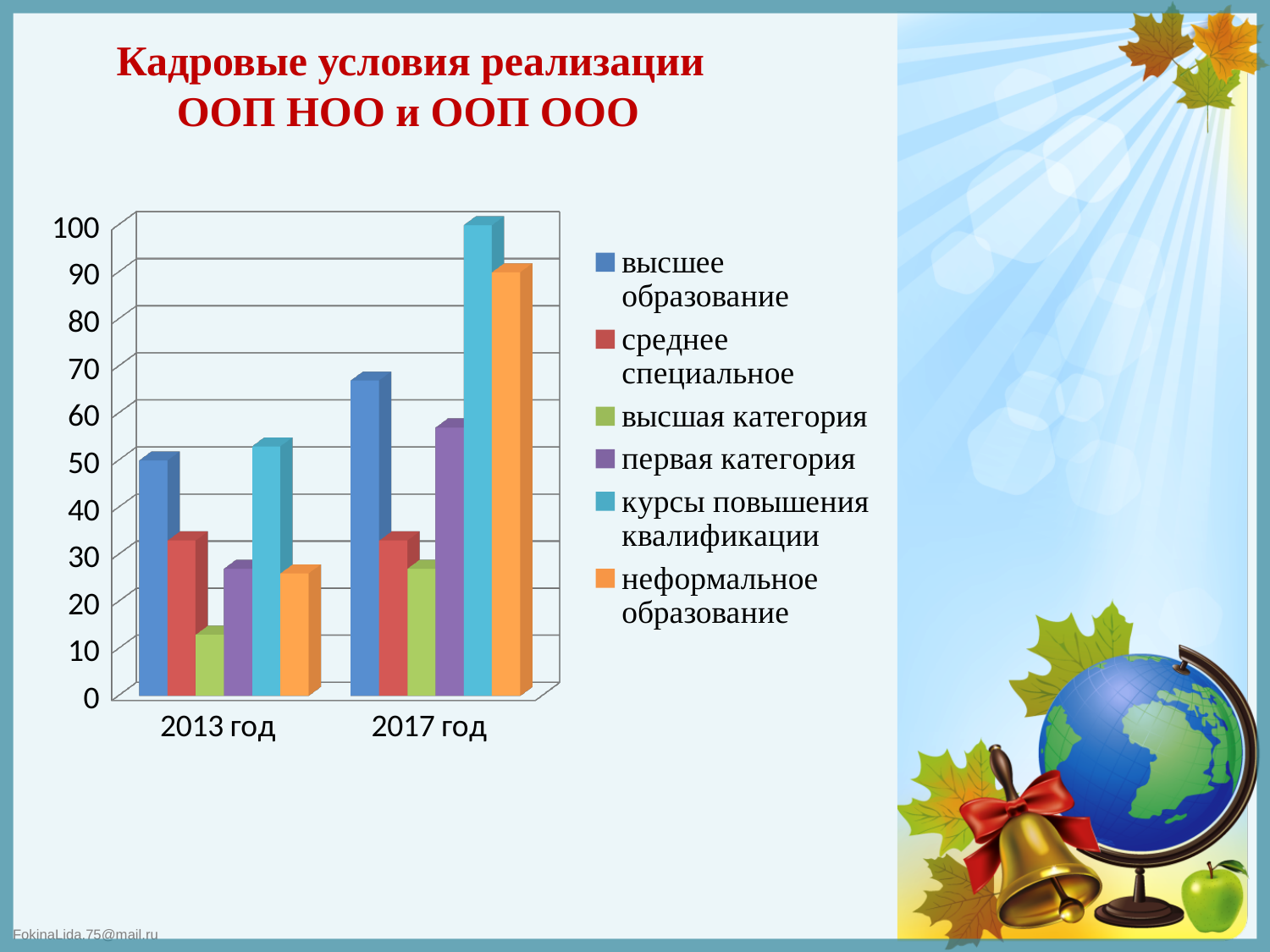
Is the value for первая категория in 2017 год greater or less than 50? greater Which legend entry is shown in orange? неформальное образование Is the value for высшая категория in 2013 год greater or less than 20? less Does the value for неформальное образование rise or fall from 2013 год to 2017 год? rise Which series has the highest value for 2017 год? курсы повышения квалификации How many series does the legend list? 6 What kind of chart is shown on the slide? bar chart How many categories are shown on the x axis? 2 Which series has the lowest value for 2013 год? высшая категория Which is larger: высшее образование in 2013 год or in 2017 год? 2017 год Is the value for курсы повышения квалификации in 2017 год greater or less than 90? greater